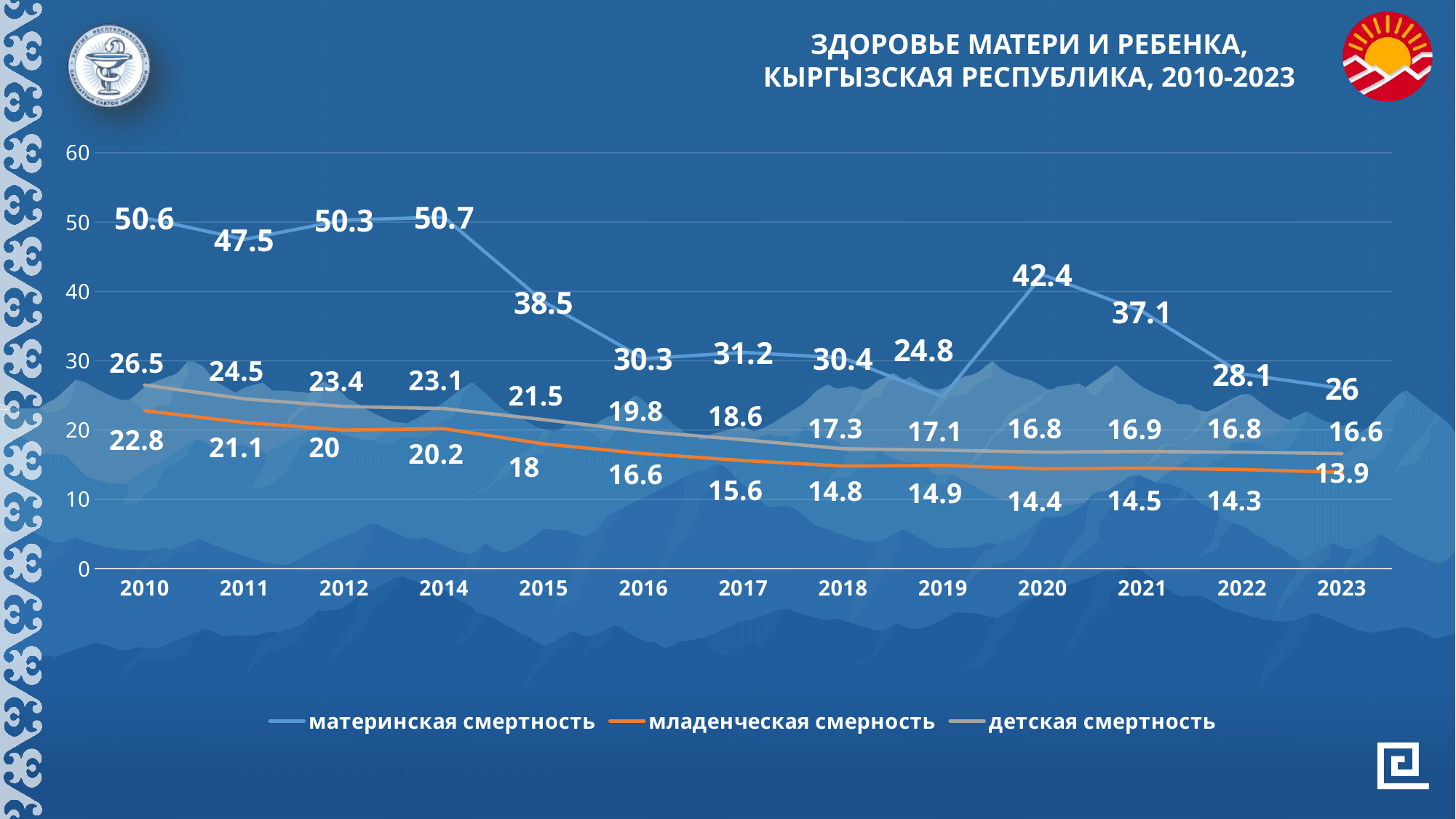
What is the value of материнская смертность in 2014? 50.7 What type of chart is shown on the slide? line chart What is the value of младенческая смерность in 2023? 13.9 What is the value of детская смертность in 2010? 26.5 Which is larger: детская смертность in 2015 or младенческая смерность in 2015? детская смертность In which year is младенческая смерность lowest? 2023 In which year is материнская смертность highest? 2014 What is the title of the chart? ЗДОРОВЬЕ МАТЕРИ И РЕБЕНКА, КЫРГЫЗСКАЯ РЕСПУБЛИКА, 2010-2023 Does детская смертность generally rise or fall from 2010 to 2023? fall What is the difference between материнская смертность in 2020 and in 2019? 17.6 How many years are plotted along the x axis? 13 How many series does the legend list? 3